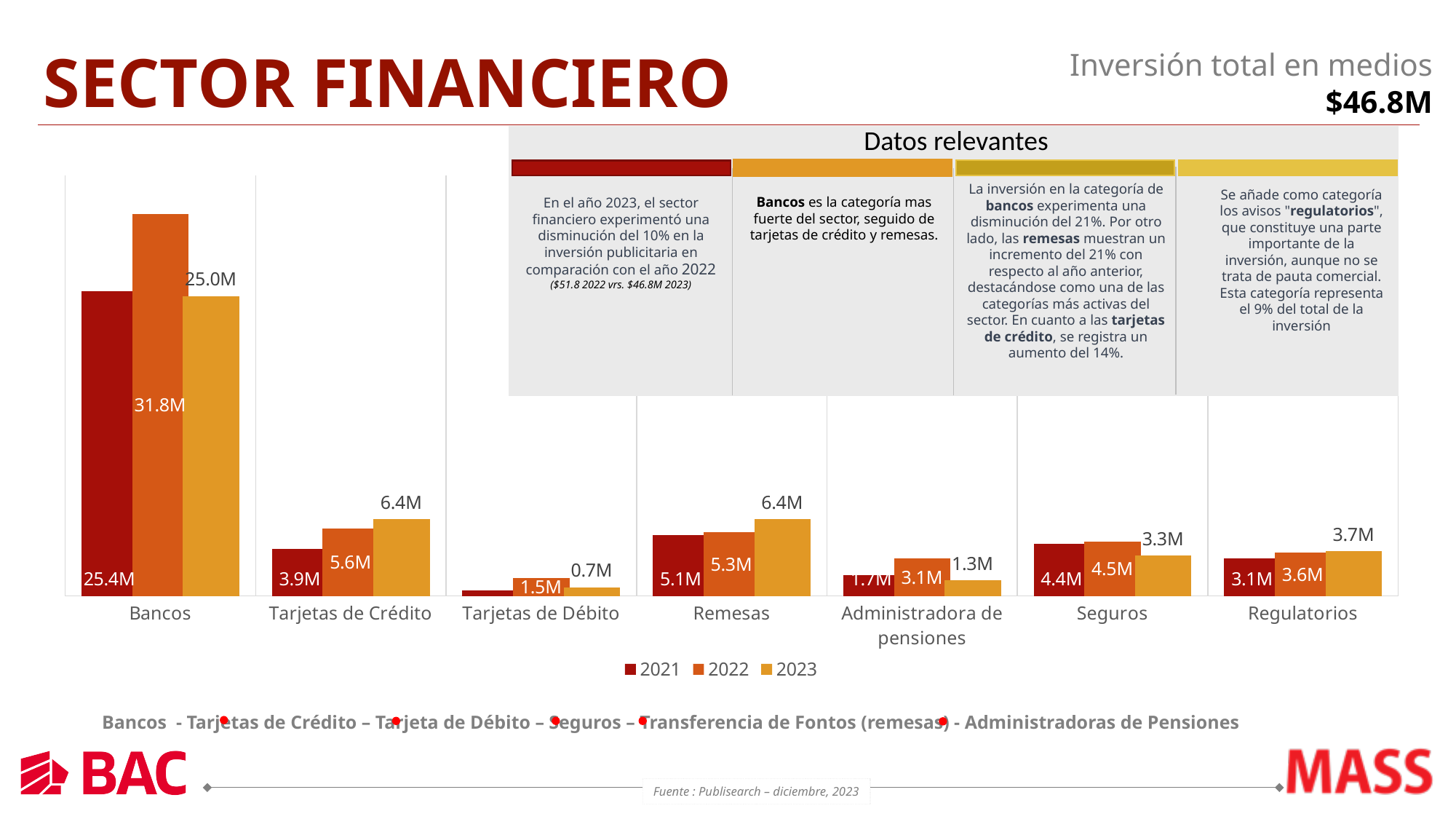
Which category has the highest value in 2023? Bancos Do the values for Regulatorios rise or fall from 2021 to 2023? Rise What kind of chart is shown on the slide? Bar chart How many series does the legend list? 3 Which is larger for Administradora de pensiones: the 2022 value or the 2023 value? 2022 Which category has the lowest value in 2023? Tarjetas de Débito What is the value for Remesas in 2023? 6.4M What is the value for Seguros in 2021? 4.4M What is the difference between the 2022 and 2023 values for Bancos? 6.8M What is the value for Tarjetas de Débito in 2023? 0.7M What is the value for Bancos in 2022? 31.8M How many categories are shown on the x axis of the chart? 7